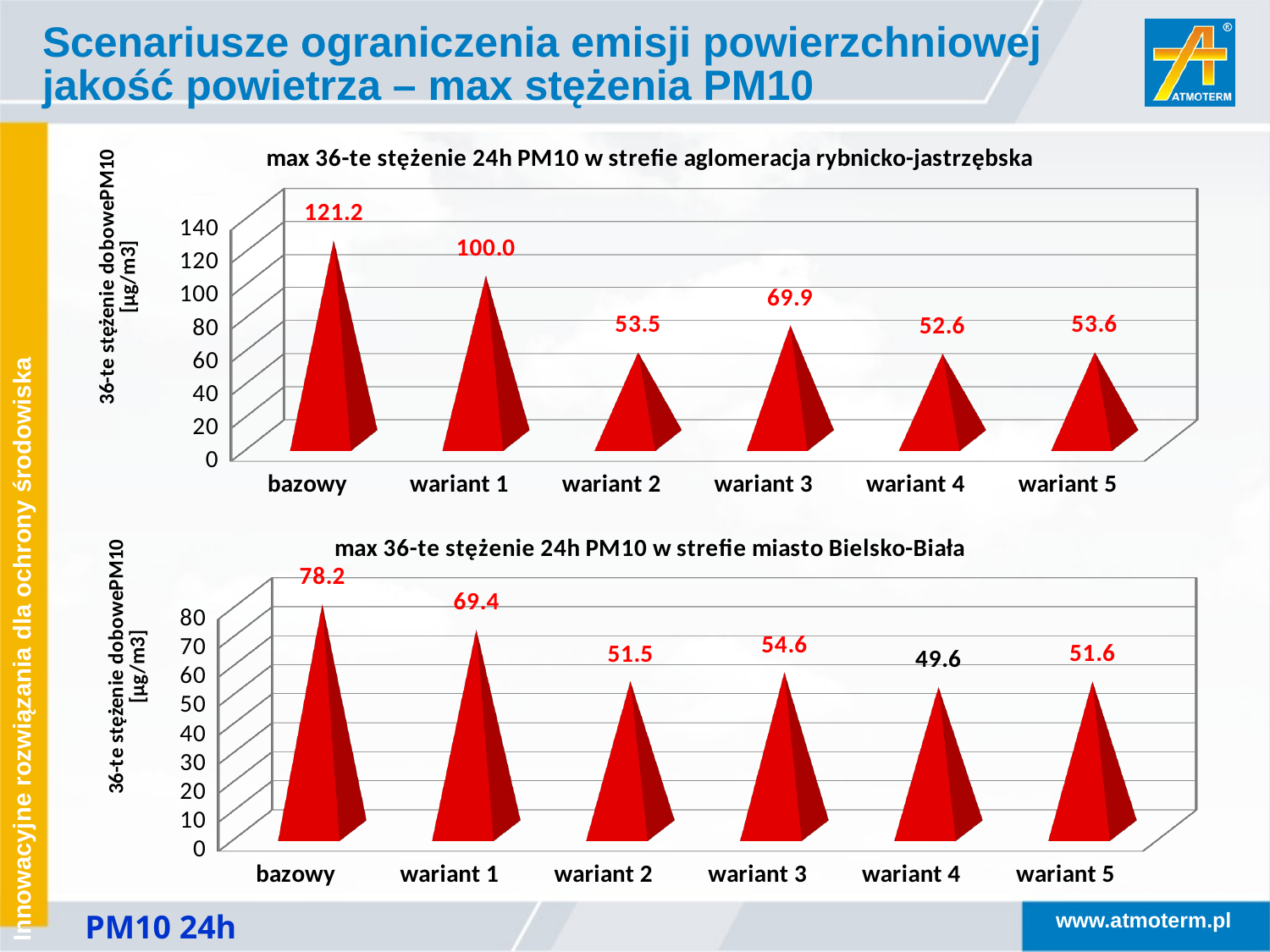
In the bottom chart (miasto Bielsko-Biała), what is the value for wariant 4? 49.6 In the top chart (aglomeracja rybnicko-jastrzębska), what is the value for bazowy? 121.2 In the bottom chart (miasto Bielsko-Biała), which is larger, wariant 2 or wariant 3? wariant 3 In the bottom chart (miasto Bielsko-Biała), is the value for wariant 1 greater or less than 60? greater What kind of chart is the top chart (aglomeracja rybnicko-jastrzębska)? bar chart In the bottom chart (miasto Bielsko-Biała), which category has the highest value? bazowy In the top chart (aglomeracja rybnicko-jastrzębska), how many categories are shown on the x axis? 6 What is the y-axis label of the bottom chart (miasto Bielsko-Biała)? 36-te stężenie dobowe PM10 [µg/m3] In the top chart (aglomeracja rybnicko-jastrzębska), what is the difference between bazowy and wariant 1? 21.2 In the top chart (aglomeracja rybnicko-jastrzębska), which category has the lowest value? wariant 4 In the top chart (aglomeracja rybnicko-jastrzębska), what is the value for wariant 3? 69.9 In the bottom chart (miasto Bielsko-Biała), what is the difference between bazowy and wariant 5? 26.6